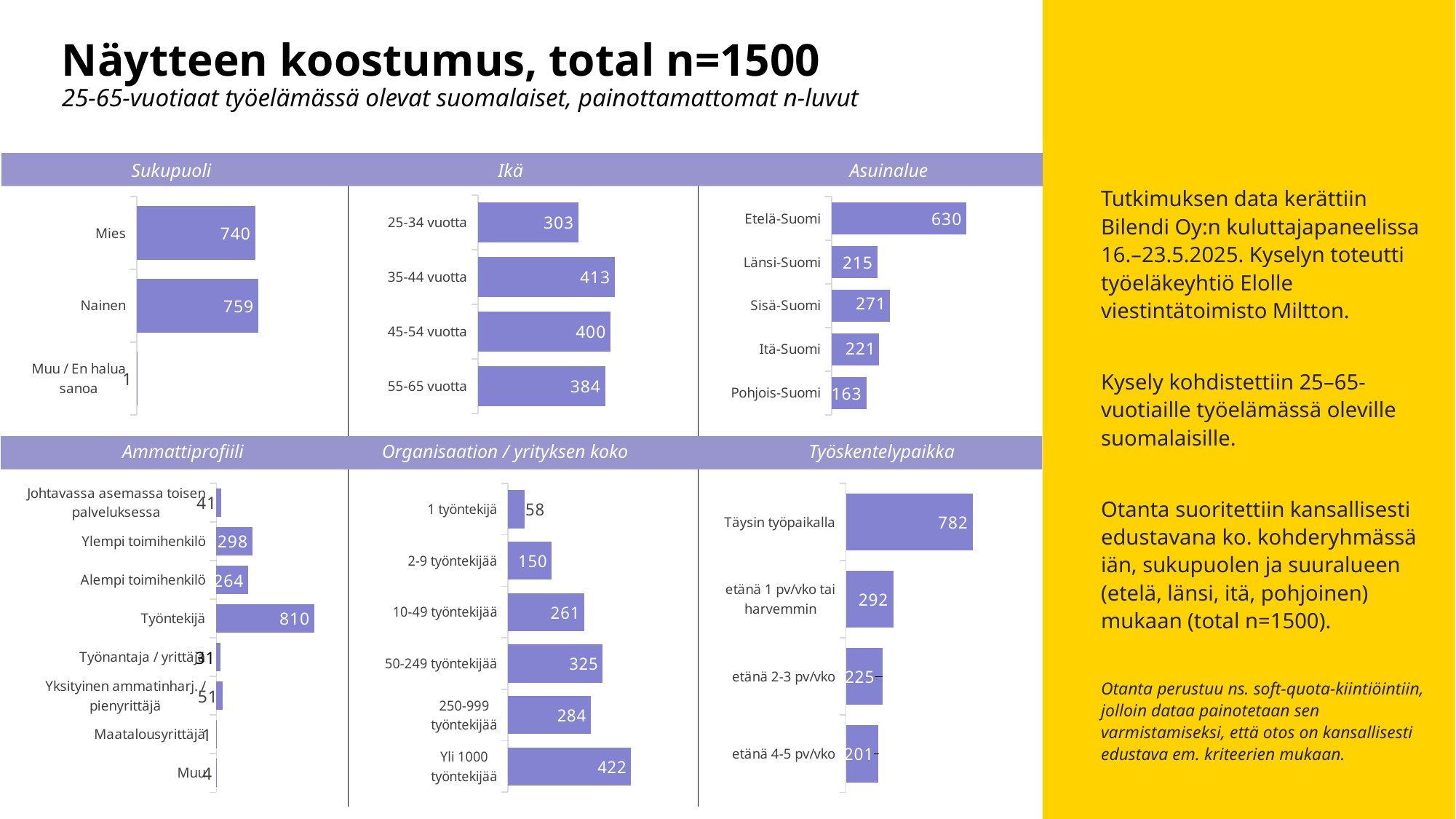
In the Työskentelypaikka chart, what is the value for Täysin työpaikalla? 782 In the Ammattiprofiili chart, which category has the highest value? Työntekijä In the Asuinalue chart, what is the value for Etelä-Suomi? 630 In the Organisaation / yrityksen koko chart, what is the value for 50-249 työntekijää? 325 In the Organisaation / yrityksen koko chart, how many categories are shown? 6 In the Asuinalue chart, which region has the lowest value? Pohjois-Suomi In the Ammattiprofiili chart, which is larger, Ylempi toimihenkilö or Alempi toimihenkilö? Ylempi toimihenkilö In the Ikä chart, what is the difference between 35-44 vuotta and 25-34 vuotta? 110 In the Ikä chart, which age group has the highest value? 35-44 vuotta In the Sukupuoli chart, what is the value for Nainen? 759 What kind of chart is the Työskentelypaikka chart? Bar chart In the Asuinalue chart, how many regions are shown? 5